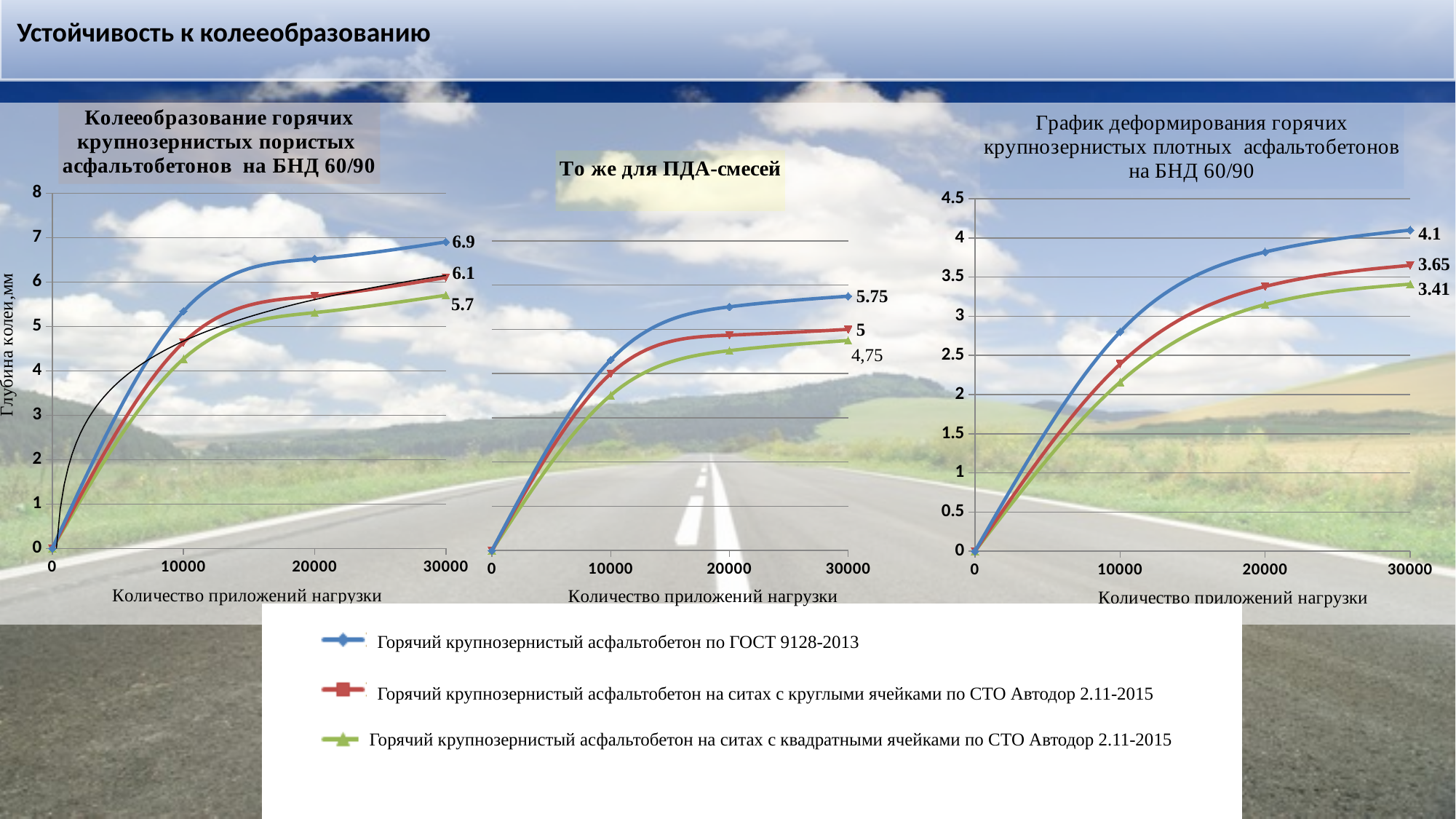
On the left chart (Колееобразование горячих крупнозернистых пористых асфальтобетонов на БНД 60/90), what is the rut depth at 30000 load applications for the blue series (по ГОСТ 9128-2013)? 6.9 What kind of chart is the middle chart (То же для ПДА-смесей)? line chart On the middle chart (То же для ПДА-смесей), what is the value at 30000 for the blue series? 5.75 On the left chart (пористых асфальтобетонов), what is the value at 30000 for the green series (на ситах с квадратными ячейками)? 5.7 On the right chart (плотных асфальтобетонов на БНД 60/90), what is the value at 30000 for the red series? 3.65 On the right chart (плотных асфальтобетонов на БНД 60/90), what is the difference between the blue series and the green series at 30000? 0.69 On the middle chart (То же для ПДА-смесей), which series has the lowest value at 30000? Горячий крупнозернистый асфальтобетон на ситах с квадратными ячейками по СТО Автодор 2.11-2015 On the left chart (пористых асфальтобетонов), what is the difference between the blue series value and the red series value at 30000? 0.8 How many series does the shared legend list? 3 On the left chart (пористых асфальтобетонов), do the values rise or fall as the number of load applications increases? rise On the middle chart (То же для ПДА-смесей), what is the value at 30000 for the red series (на ситах с круглыми ячейками)? 5 On the right chart (плотных асфальтобетонов на БНД 60/90), is the blue series value at 10000 load applications greater or less than 2.5? greater